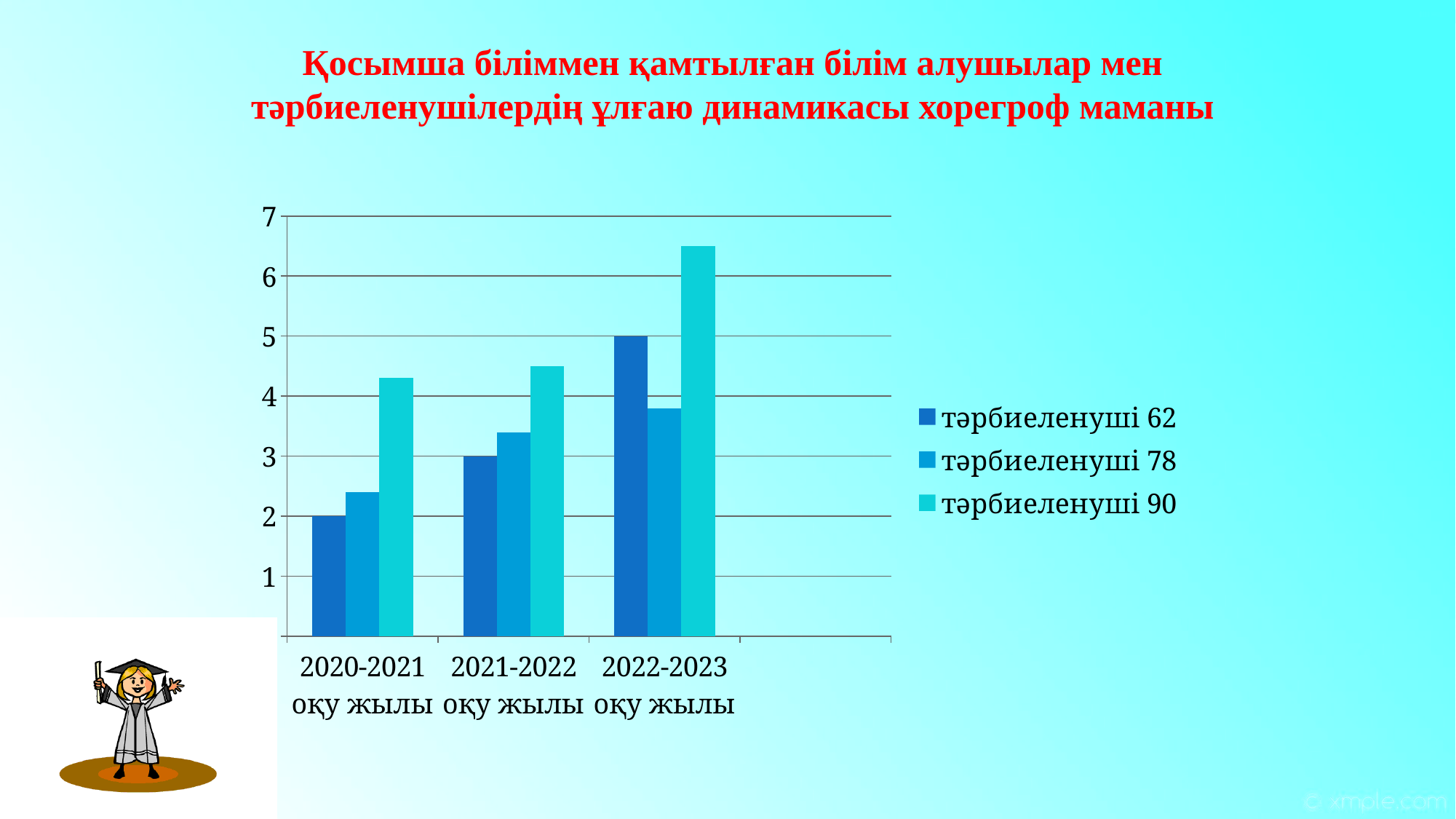
Is the value for тәрбиеленуші 90 in 2022-2023 оқу жылы greater or less than 6? greater In 2022-2023 оқу жылы, which is larger: тәрбиеленуші 62 or тәрбиеленуші 78? тәрбиеленуші 62 How many series does the legend list? 3 Do the values for тәрбиеленуші 62 rise or fall from 2020-2021 to 2022-2023? rise Is the value for тәрбиеленуші 78 in 2020-2021 оқу жылы greater or less than 3? less How many academic-year categories are shown on the x axis? 3 What is the value for тәрбиеленуші 62 in 2021-2022 оқу жылы? 3 What is the value for тәрбиеленуші 62 in 2022-2023 оқу жылы? 5 What is the value for тәрбиеленуші 62 in 2020-2021 оқу жылы? 2 What kind of chart is shown on the slide? bar chart In which academic year is the value for тәрбиеленуші 90 the highest? 2022-2023 оқу жылы By how much does the value for тәрбиеленуші 62 in 2022-2023 оқу жылы exceed its value in 2020-2021 оқу жылы? 3